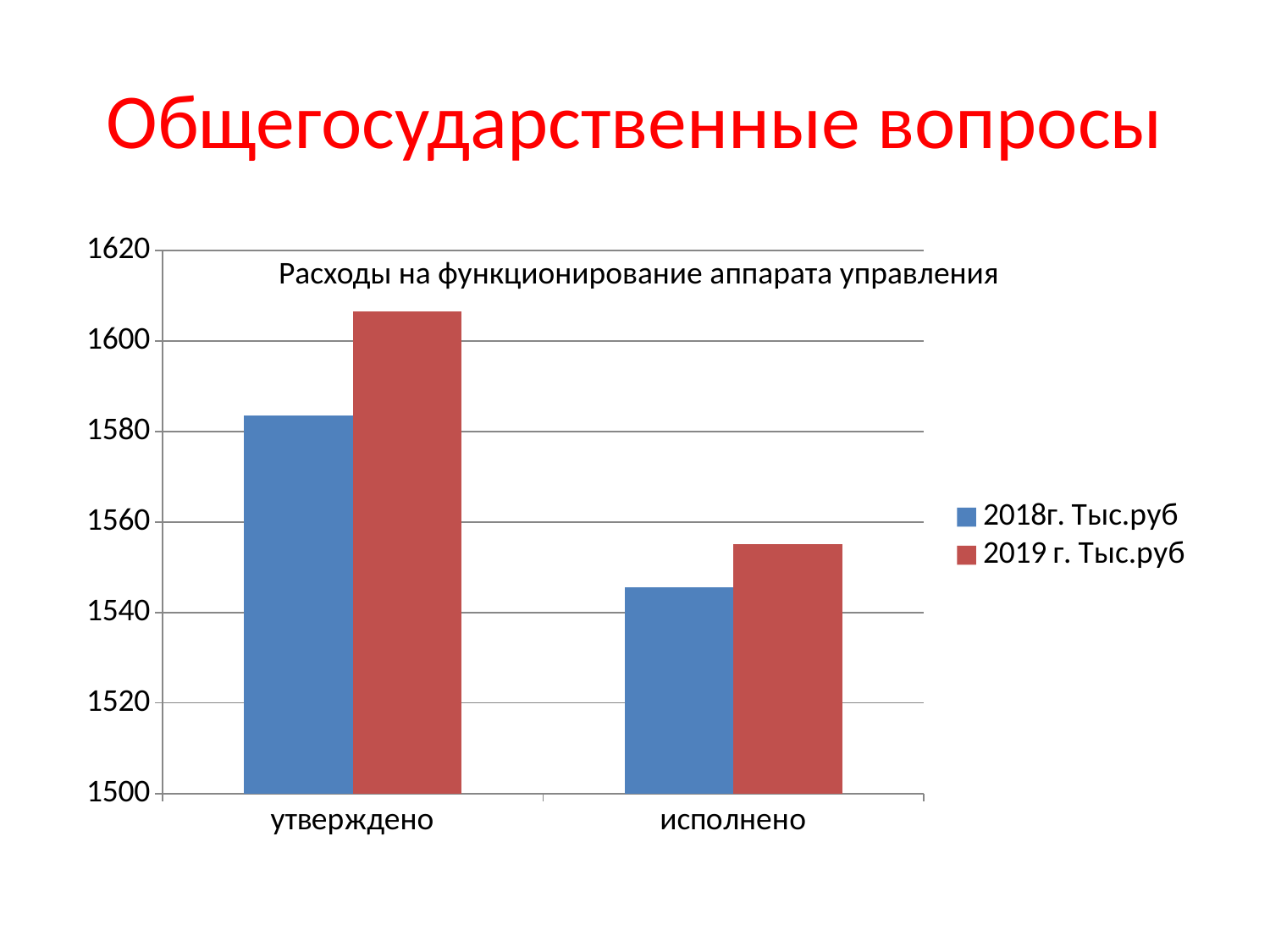
Which category has the highest value in the 2019 г. Тыс.руб series? утверждено How many series does the legend list? 2 Is the value for исполнено in the 2019 г. Тыс.руб series greater or less than 1560? less What is the title of the chart? Расходы на функционирование аппарата управления Which category has the lowest value in the 2018г. Тыс.руб series? исполнено Is the value for утверждено in the 2019 г. Тыс.руб series greater or less than 1600? greater Is the value for утверждено in the 2018г. Тыс.руб series greater or less than 1560? greater For утверждено, which series has the larger value, 2018г. Тыс.руб or 2019 г. Тыс.руб? 2019 г. Тыс.руб What kind of chart is shown on the slide? bar chart How many categories are shown on the x axis? 2 Which series is shown in red? 2019 г. Тыс.руб